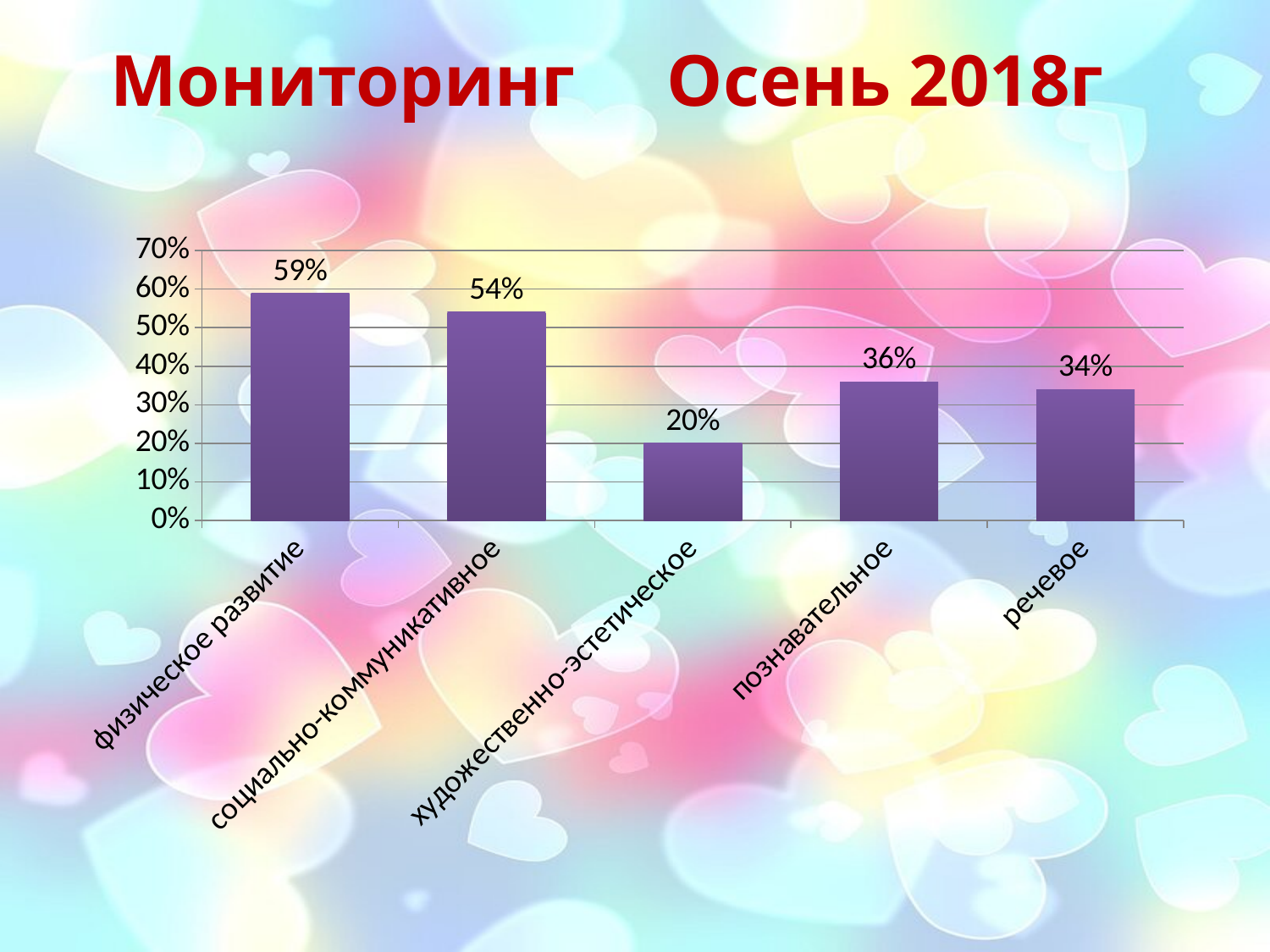
What is the difference between the values for физическое развитие and художественно-эстетическое? 39% What is the value for физическое развитие? 59% Which category has the highest value? физическое развитие What is the title of the slide? Мониторинг Осень 2018г What kind of chart is shown on the slide? bar chart What is the value for социально-коммуникативное? 54% Which category has the lowest value? художественно-эстетическое What is the value for художественно-эстетическое? 20% What is the value for познавательное? 36% How many categories are shown on the chart? 5 Which is larger, the value for познавательное or the value for речевое? познавательное What is the value for речевое? 34%